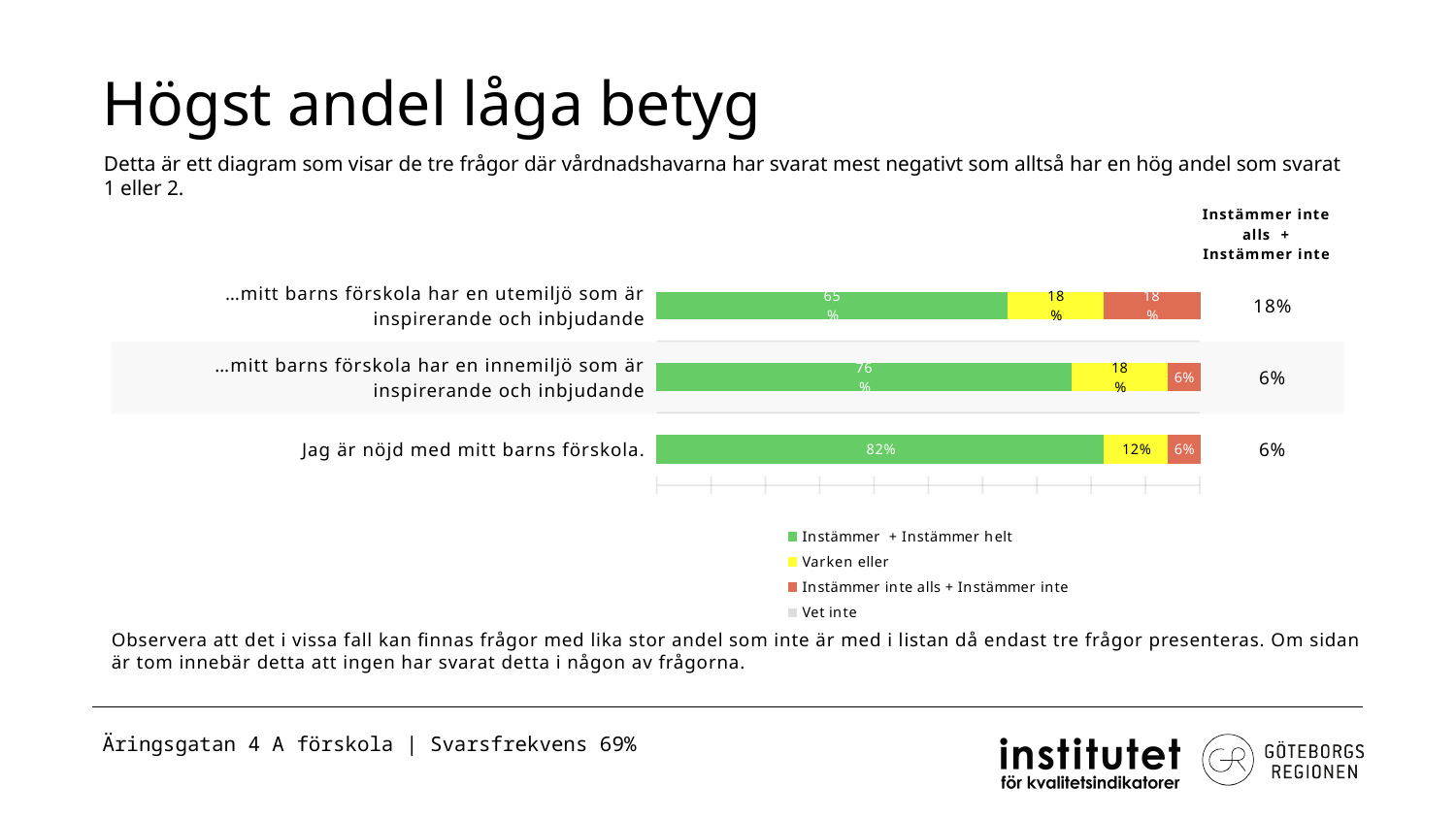
Which category has the lowest value for "Instämmer + Instämmer helt"? …mitt barns förskola har en utemiljö som är inspirerande och inbjudande What is the value of "Instämmer inte alls + Instämmer inte" for "…mitt barns förskola har en utemiljö som är inspirerande och inbjudande"? 18% What is the value of "Instämmer + Instämmer helt" for "…mitt barns förskola har en utemiljö som är inspirerande och inbjudande"? 65% Which category has the highest value for "Instämmer + Instämmer helt"? Jag är nöjd med mitt barns förskola. Which is larger: the "Varken eller" value for "…mitt barns förskola har en innemiljö som är inspirerande och inbjudande" or for "Jag är nöjd med mitt barns förskola."? …mitt barns förskola har en innemiljö som är inspirerande och inbjudande What is the value of "Varken eller" for "…mitt barns förskola har en innemiljö som är inspirerande och inbjudande"? 18% What is the value of "Instämmer + Instämmer helt" for "Jag är nöjd med mitt barns förskola."? 82% What kind of chart is shown on the slide? stacked bar chart What is the title of the slide containing the chart? Högst andel låga betyg How many categories (questions) are plotted in the chart? 3 What is the difference between the "Instämmer + Instämmer helt" values for "Jag är nöjd med mitt barns förskola." and "…mitt barns förskola har en utemiljö som är inspirerande och inbjudande"? 17% How many series does the legend list? 4